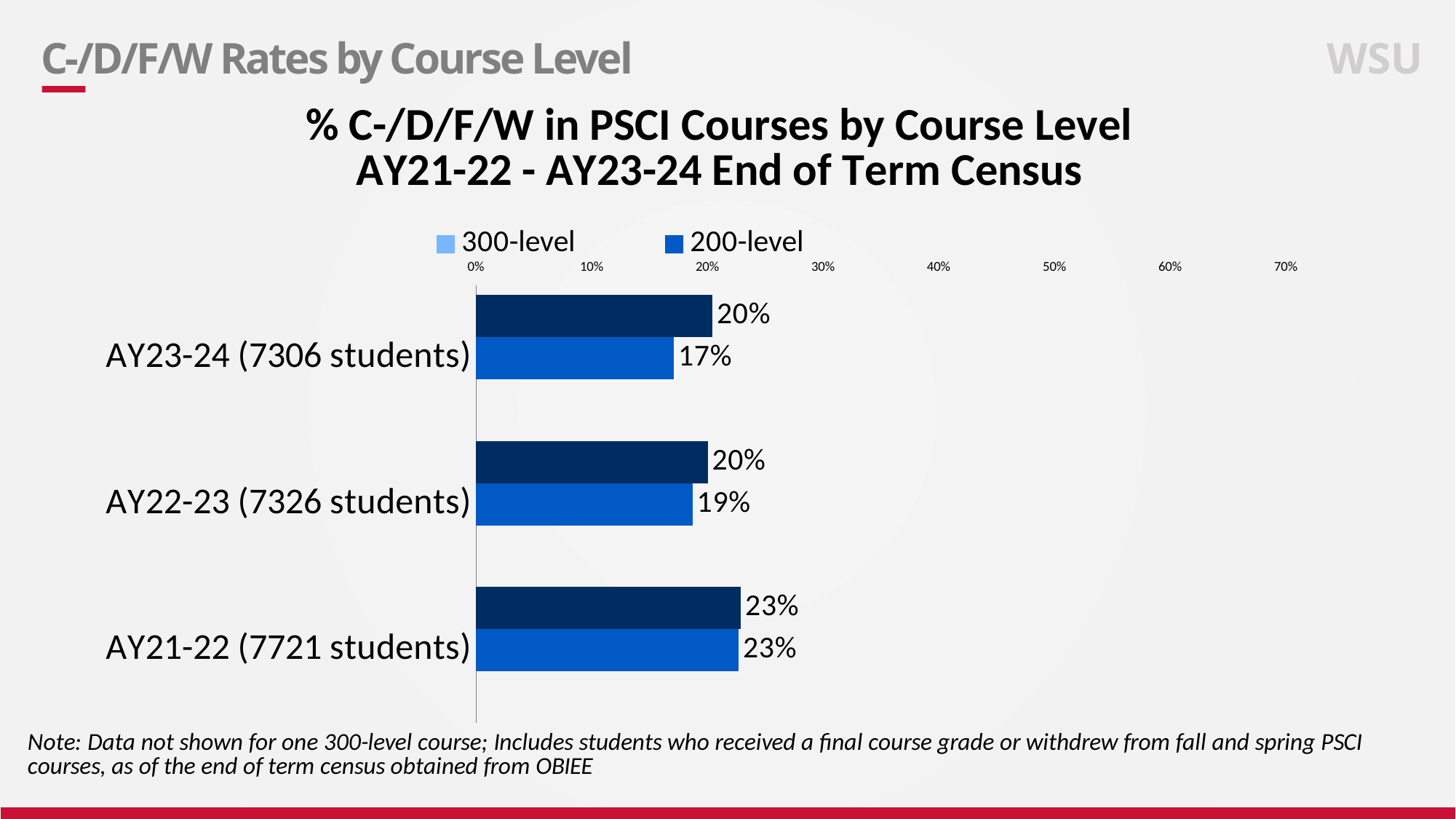
Which academic year has the highest 200-level C-/D/F/W rate? AY21-22 (7721 students) Do the 200-level C-/D/F/W rates rise or fall from AY21-22 to AY23-24? fall What is the 200-level C-/D/F/W rate for AY22-23 (7326 students)? 19% Which academic year has the lowest 200-level C-/D/F/W rate? AY23-24 (7306 students) How many academic years are shown on the chart? 3 What is the 200-level C-/D/F/W rate for AY21-22 (7721 students)? 23% Which is larger, the 200-level rate for AY22-23 or the 200-level rate for AY23-24? AY22-23 What kind of chart is shown on the slide? bar chart By how many percentage points does the 200-level rate for AY21-22 exceed the 200-level rate for AY23-24? 6 percentage points How many series does the chart legend list? 2 What are the two entries in the chart legend? 300-level and 200-level What is the 200-level C-/D/F/W rate for AY23-24 (7306 students)? 17%